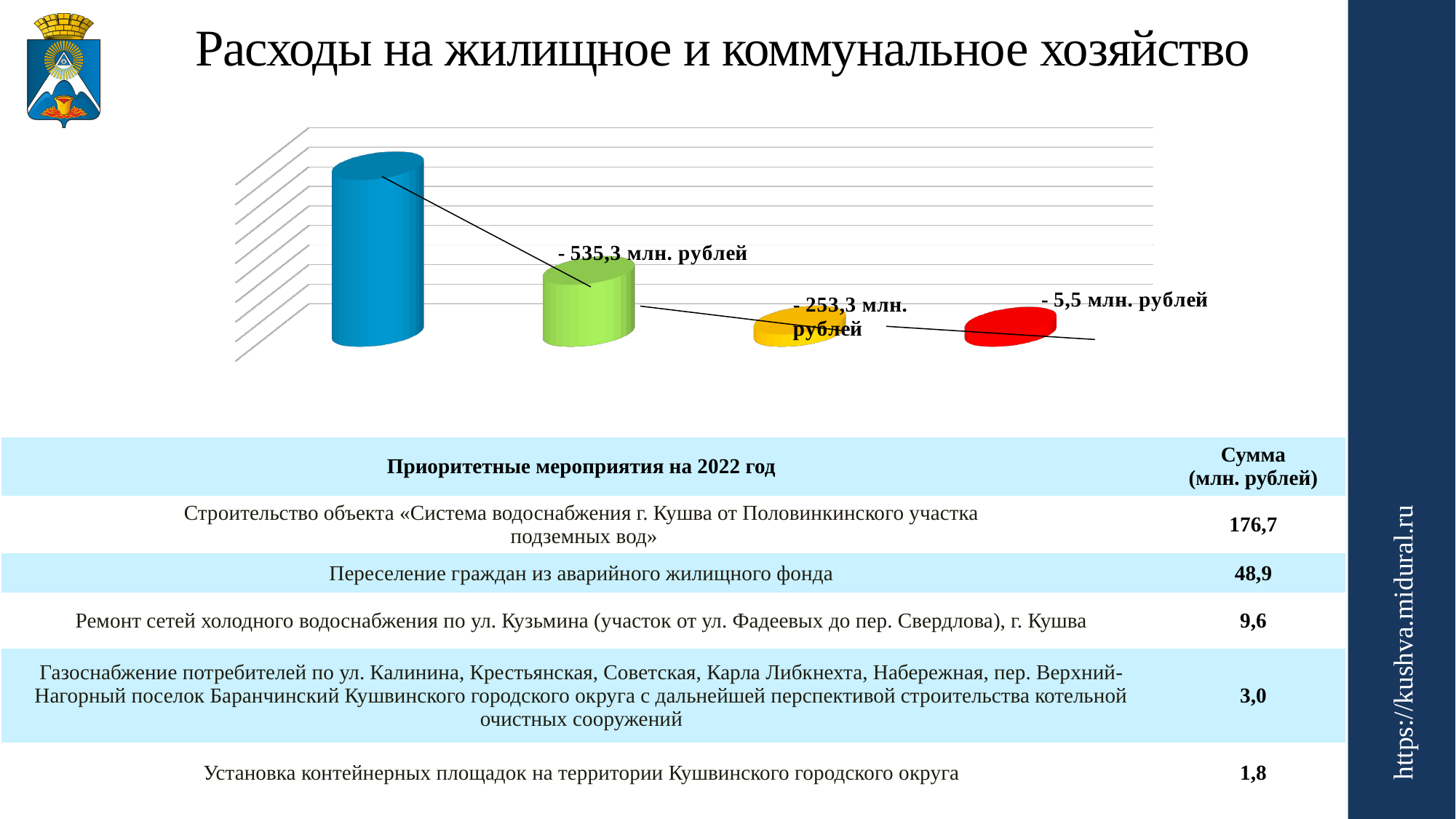
Is the green bar taller or shorter than the red bar? taller Which bar in the chart is the tallest? the blue bar (first from the left) Do the bar heights rise or fall from left to right across the chart? fall What is the title of the slide containing the chart? Расходы на жилищное и коммунальное хозяйство What colour is the tallest bar in the chart? blue Is the blue bar taller or shorter than the green bar? taller What kind of chart is shown on the slide? bar chart How many bars does the chart contain? 4